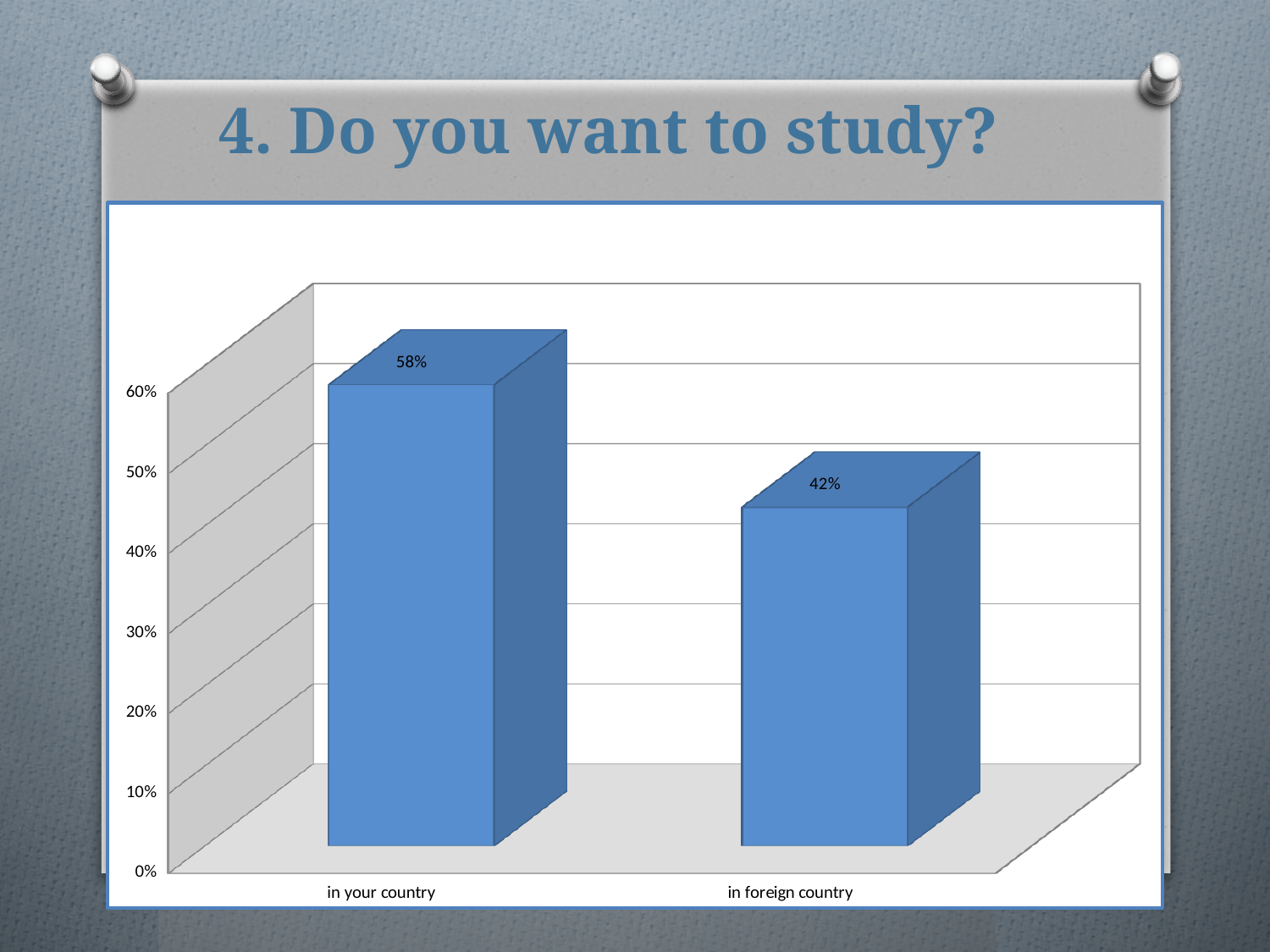
What is the title of the slide above the chart? 4. Do you want to study? What is the value for "in your country"? 58% What is the highest value labelled on the vertical axis? 60% What is the difference between the values for "in your country" and "in foreign country"? 16% What kind of chart is shown on the slide? bar chart How many categories are shown on the x axis? 2 What is the value for "in foreign country"? 42% Is the value for "in foreign country" greater or less than 50%? less Is the value for "in your country" greater or less than 50%? greater Which is larger, the value for "in your country" or "in foreign country"? in your country Which category has the lowest value? in foreign country Which category has the highest value? in your country